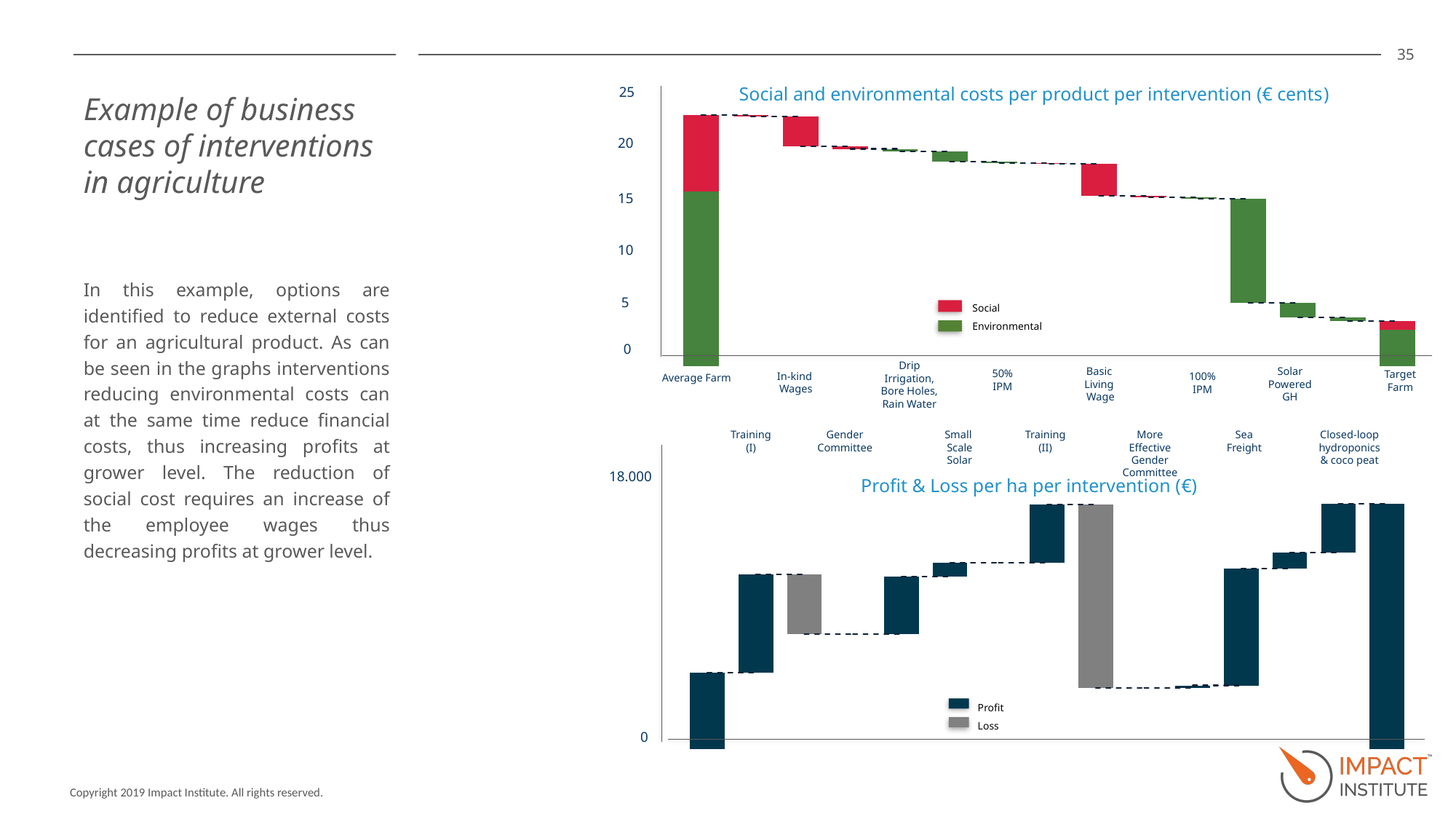
In the 'Profit & Loss per ha per intervention (€)' chart, how many bars are shown in the grey Loss colour? 2 How many series does the legend of the 'Social and environmental costs per product per intervention' chart list? 2 How many series does the legend of the 'Profit & Loss per ha per intervention (€)' chart list? 2 In the 'Social and environmental costs per product per intervention' chart, which is larger, the total for Average Farm or the total for Target Farm? Average Farm In the 'Social and environmental costs per product per intervention' chart, is the total value for Average Farm greater or less than 20? greater In the 'Profit & Loss per ha per intervention (€)' chart, is the value of the last (rightmost) bar greater or less than 18.000? less In the 'Social and environmental costs per product per intervention' chart, do the cumulative costs rise or fall from Average Farm to Target Farm? fall In the 'Social and environmental costs per product per intervention' chart, which series is shown in green? Environmental In the 'Social and environmental costs per product per intervention' chart, which series does the Basic Living Wage bar belong to? Social What is the highest tick value on the y axis of the 'Social and environmental costs per product per intervention' chart? 25 What kind of chart is the 'Social and environmental costs per product per intervention (€ cents)' chart? bar chart In the 'Social and environmental costs per product per intervention' chart, is the total value for Target Farm greater or less than 5? less